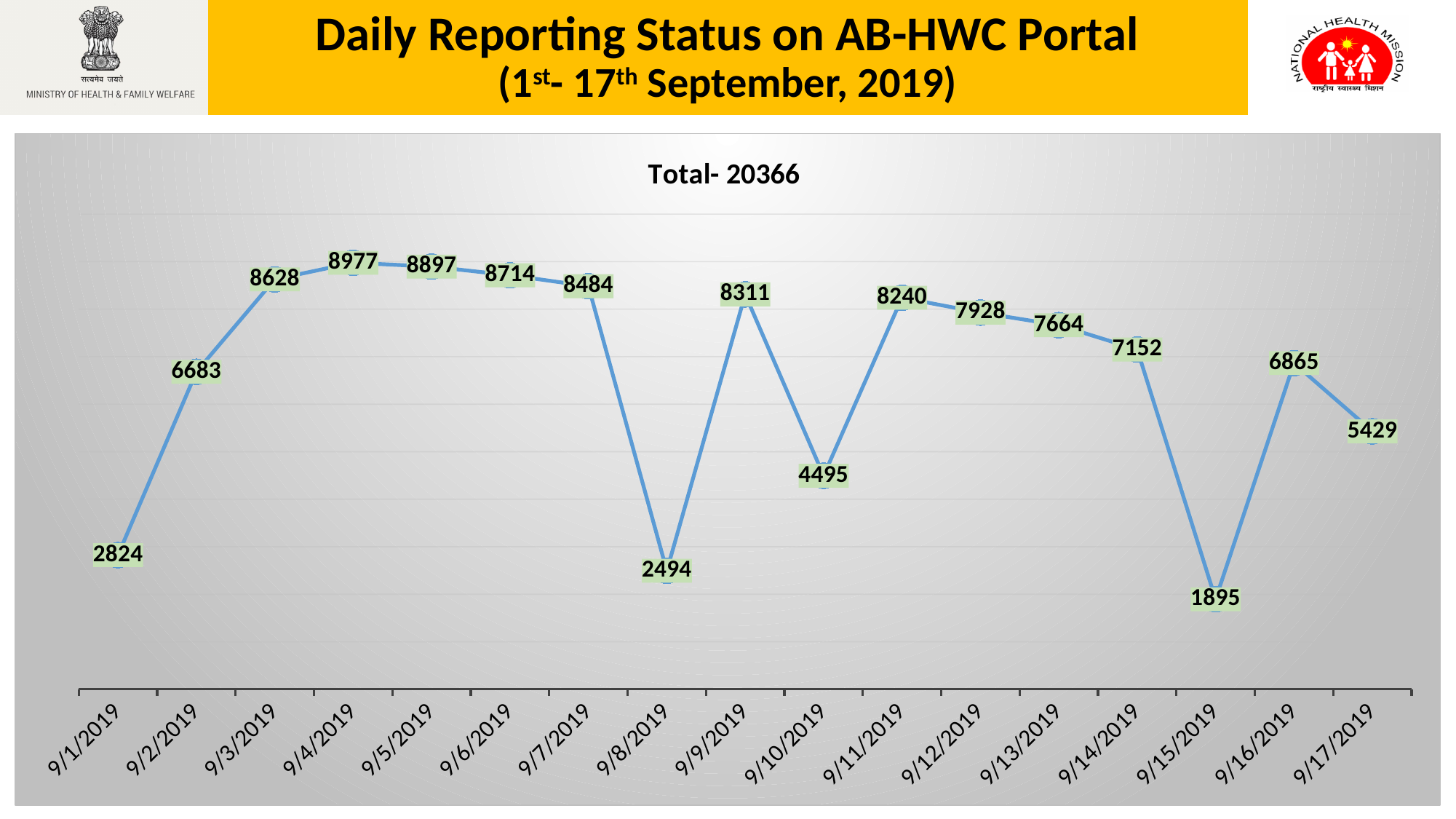
What is the value plotted for 9/4/2019? 8977 Which date has the lowest value on the chart? 9/15/2019 Which date has the highest value on the chart? 9/4/2019 How many dates are plotted on the x axis? 17 What is the value plotted for 9/15/2019? 1895 Do the values rise or fall from 9/11/2019 to 9/15/2019? Fall What is the value plotted for 9/10/2019? 4495 What is the difference between the values for 9/7/2019 and 9/8/2019? 5990 What kind of chart is shown on the slide? Line chart What total is stated in the chart title? 20366 Which is larger, the value for 9/2/2019 or the value for 9/14/2019? 9/14/2019 What is the difference between the values for 9/16/2019 and 9/17/2019? 1436